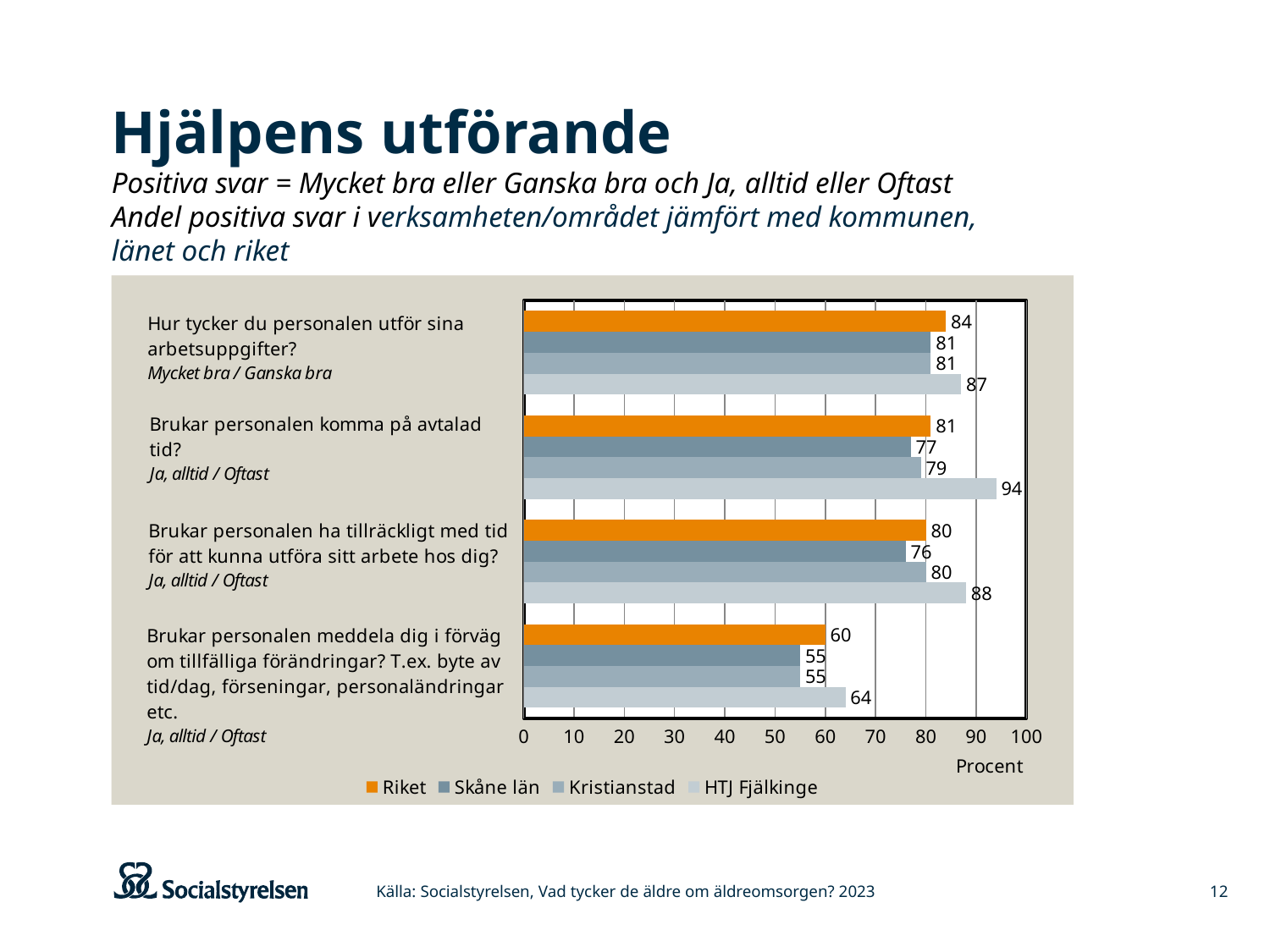
What is the difference between Riket and Skåne län on "Brukar personalen meddela dig i förväg om tillfälliga förändringar?"? 5 What is the value for Skåne län on "Brukar personalen ha tillräckligt med tid för att kunna utföra sitt arbete hos dig?"? 76 What is the label of the x axis? Procent Which question has the lowest value for Riket? Brukar personalen meddela dig i förväg om tillfälliga förändringar? Which is larger on "Brukar personalen ha tillräckligt med tid för att kunna utföra sitt arbete hos dig?": HTJ Fjälkinge or Kristianstad? HTJ Fjälkinge How many series does the legend list? 4 What kind of chart is shown on the slide? Bar chart What is the value for Riket on "Hur tycker du personalen utför sina arbetsuppgifter?"? 84 Which series has the highest value on "Brukar personalen komma på avtalad tid?"? HTJ Fjälkinge What is the value for Kristianstad on "Brukar personalen meddela dig i förväg om tillfälliga förändringar?"? 55 What is the difference between HTJ Fjälkinge and Riket on "Brukar personalen komma på avtalad tid?"? 13 What is the value for HTJ Fjälkinge on "Brukar personalen komma på avtalad tid?"? 94